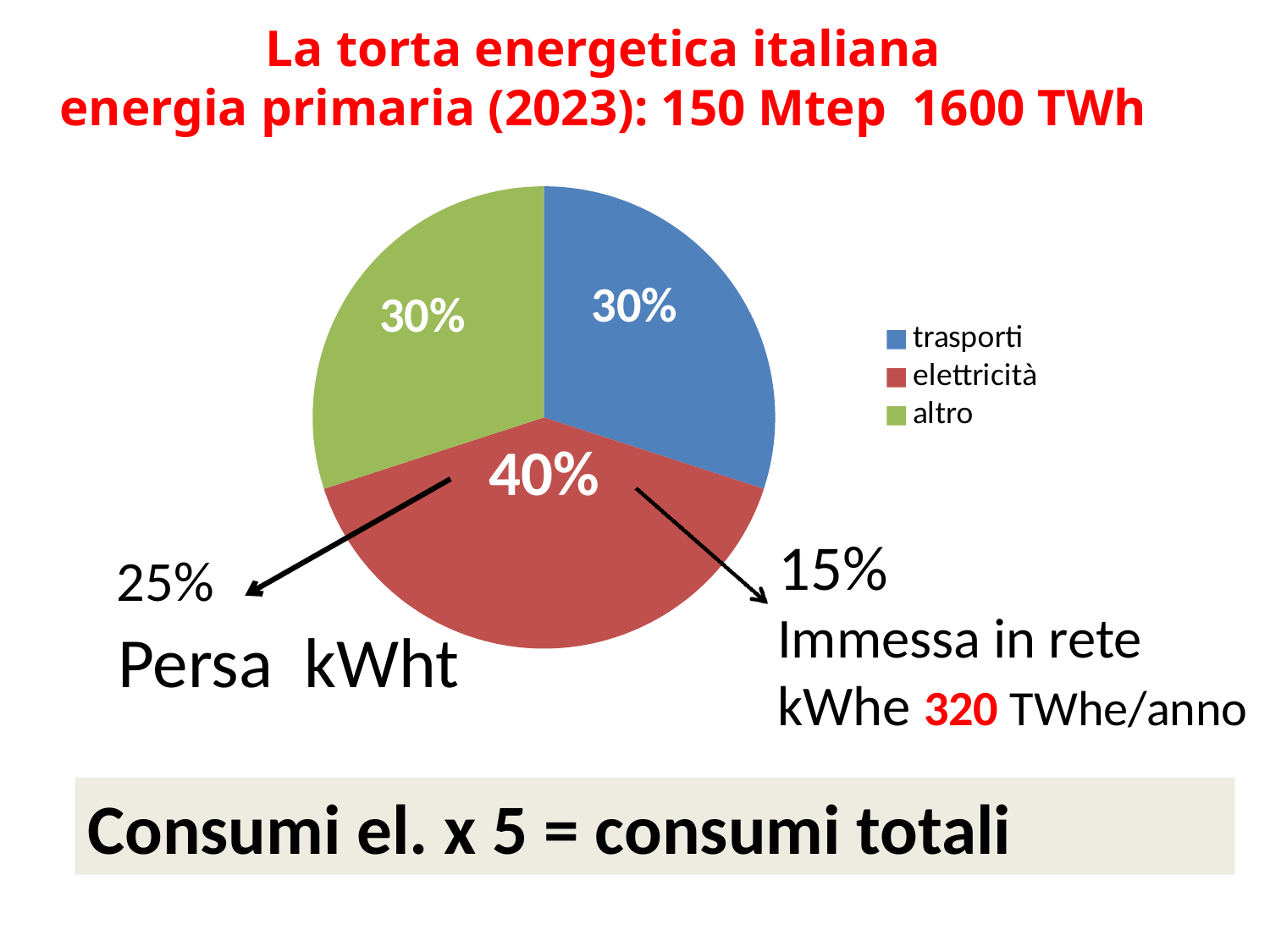
What kind of chart is shown on the slide? pie chart Which category has the largest slice of the pie? elettricità What is the difference between the elettricità share and the trasporti share? 10% What share of the pie does trasporti have? 30% What colour is the trasporti slice? blue Which is larger, the elettricità slice or the altro slice? elettricità What colour is the elettricità slice? red How many entries does the legend list? 3 How many slices does the pie chart have? 3 What is the combined share of trasporti and altro? 60% What share of the pie does altro have? 30% What share of the pie does elettricità have? 40%